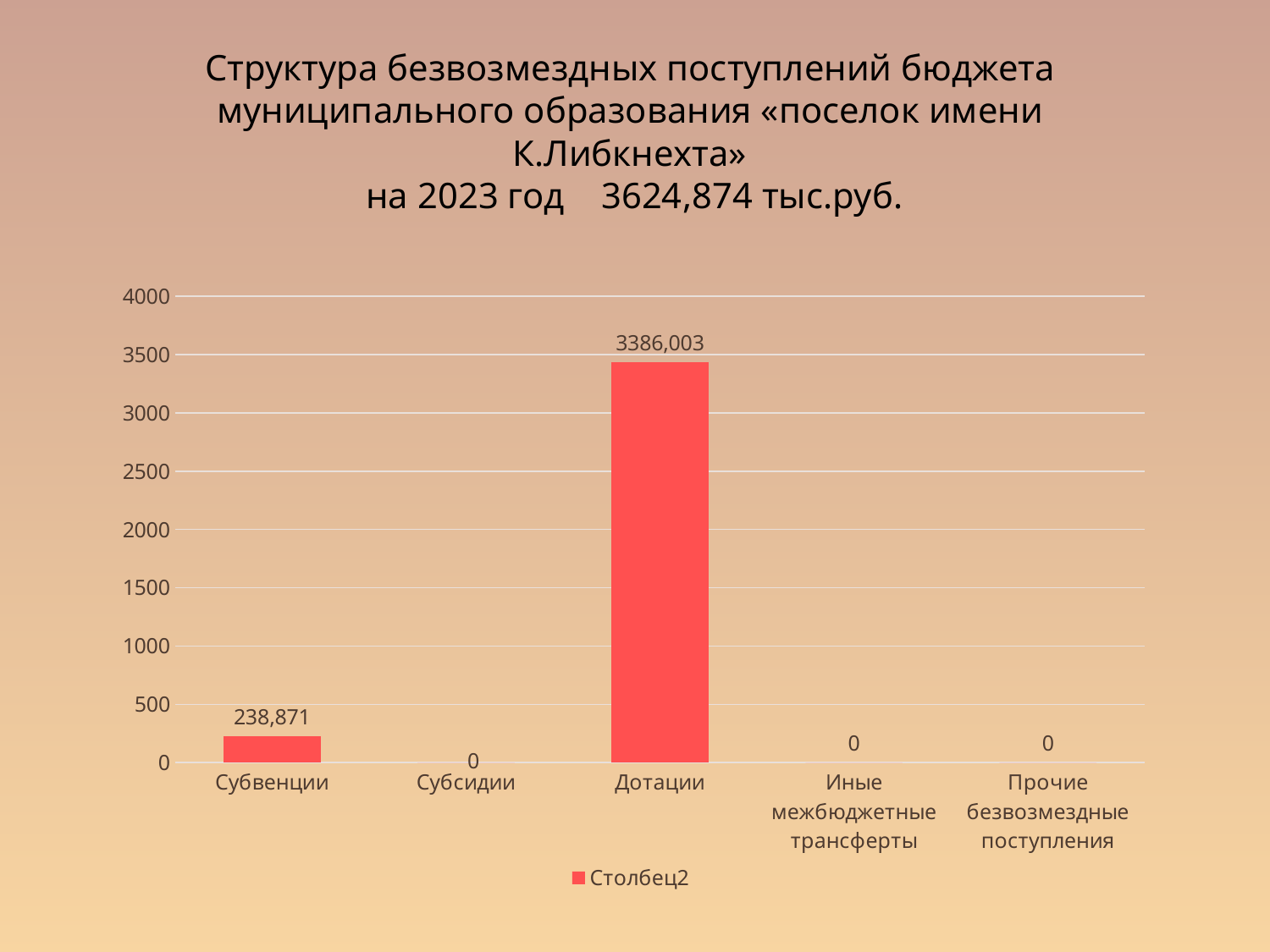
What is the value for Дотации? 3386,003 Which category has the highest value? Дотации How many categories are shown on the x axis? 5 What is the value for Субвенции? 238,871 Is the value for Субвенции greater or less than 500? less What is the value for Субсидии? 0 Which is larger, the value for Субвенции or the value for Дотации? Дотации What kind of chart is shown on the slide? bar chart What series name is listed in the legend? Столбец2 What is the value for Иные межбюджетные трансферты? 0 Is the value for Дотации greater or less than 3000? greater What is the difference between the values for Дотации and Субвенции? 3147,132